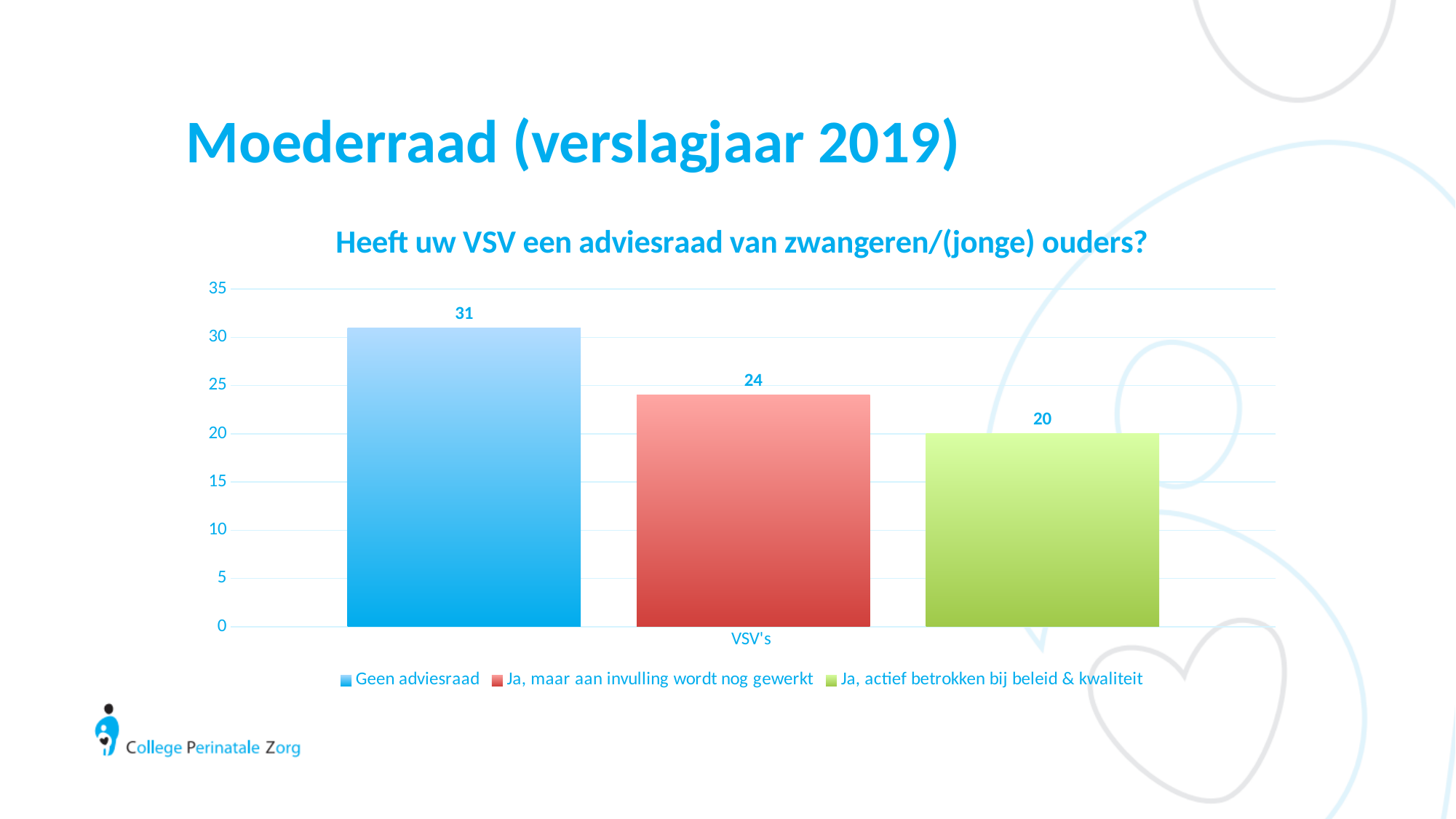
How many series does the legend list? 3 Which series has the highest value? Geen adviesraad What is the value for 'Ja, actief betrokken bij beleid & kwaliteit'? 20 Which is larger: 'Ja, maar aan invulling wordt nog gewerkt' or 'Ja, actief betrokken bij beleid & kwaliteit'? Ja, maar aan invulling wordt nog gewerkt What kind of chart is shown on the slide? bar chart What is the title of the chart? Heeft uw VSV een adviesraad van zwangeren/(jonge) ouders? Is the value for 'Geen adviesraad' greater or less than 30? greater Which series has the lowest value? Ja, actief betrokken bij beleid & kwaliteit What is the difference between the values for 'Geen adviesraad' and 'Ja, actief betrokken bij beleid & kwaliteit'? 11 What is the label on the x axis of the chart? VSV's What is the value for 'Geen adviesraad'? 31 What is the value for 'Ja, maar aan invulling wordt nog gewerkt'? 24